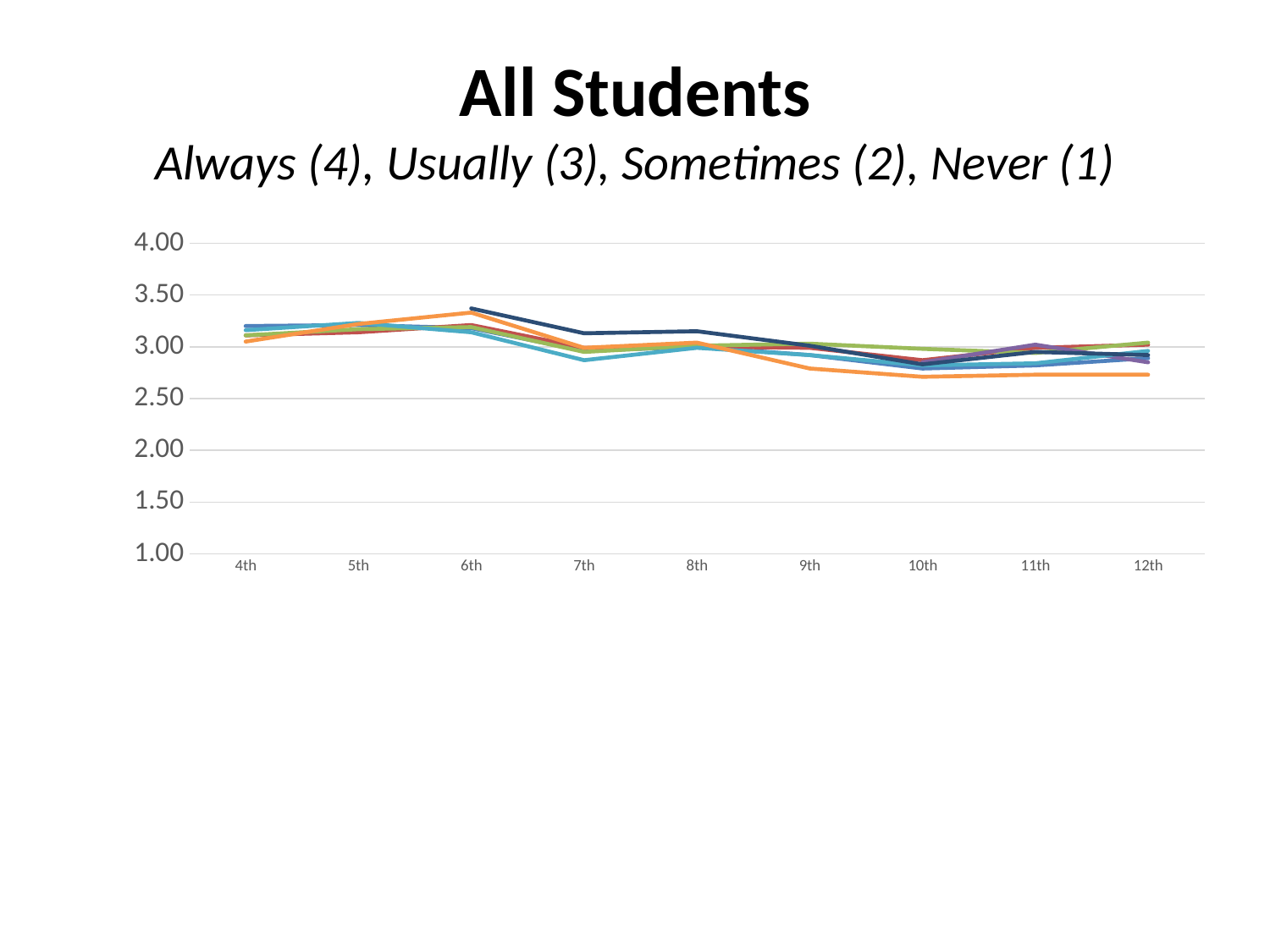
Is the value for the orange line at 12th grade greater or less than 3.00? less Do the plotted values generally rise or fall from 4th grade to 12th grade? Fall Is the value for the orange line at 9th grade greater or less than 3.00? less What is the lowest value shown on the y axis? 1.00 What rating scale is described in the subtitle under the chart title? Always (4), Usually (3), Sometimes (2), Never (1) Is the value for the dark blue line at 6th grade greater or less than 3.00? greater At which grade level do the lines reach their highest values? 6th What kind of chart is shown on the slide? Line chart How many grade levels are shown along the x axis? 9 What is the title of the chart on the slide? All Students